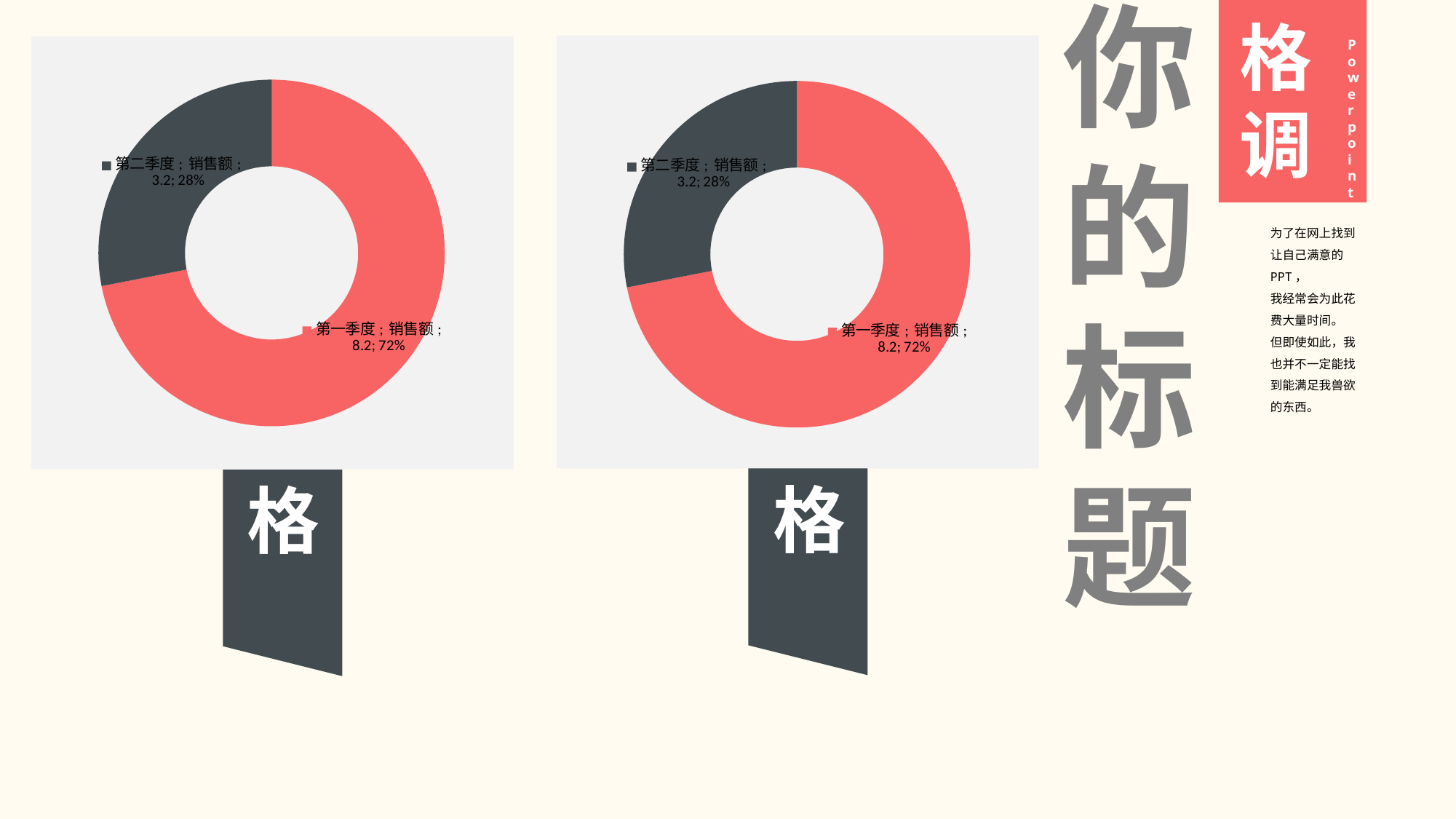
In the right chart, what percentage share does 第一季度 have? 72% What series name is shown in the data labels of the right chart? 销售额 How many categories does the left chart show? 2 In the left chart, which category has the largest slice? 第一季度 In the right chart, which is larger, the value for 第一季度 or 第二季度? 第一季度 In the right chart, which category has the smallest slice? 第二季度 In the left chart, what is the value for 第一季度? 8.2 What kind of chart is the right chart? doughnut chart In the left chart, what colour is the 第二季度 slice? dark grey In the left chart, what is the difference between the values for 第一季度 and 第二季度? 5.0 In the right chart, what percentage share does 第二季度 have? 28% In the left chart, what is the value for 第二季度? 3.2